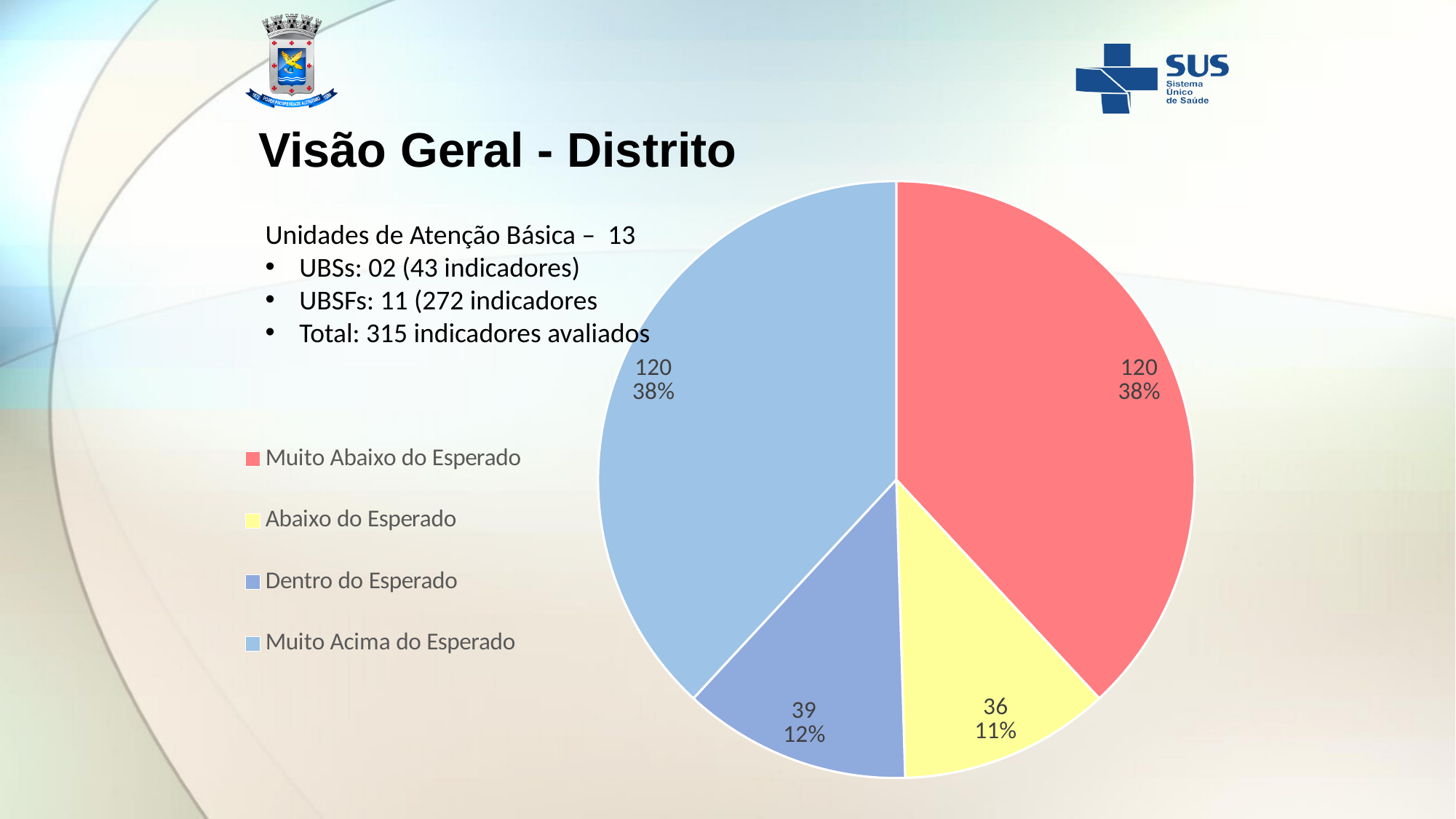
What is the value for Dentro do Esperado? 39 What share of the pie does Abaixo do Esperado represent? 11% Which is larger, Dentro do Esperado or Abaixo do Esperado? Dentro do Esperado How many slices does the pie chart have? 4 What is the difference between the values for Muito Abaixo do Esperado and Dentro do Esperado? 81 What is the value for Abaixo do Esperado? 36 What is the value for Muito Acima do Esperado? 120 What kind of chart is shown on the slide? pie chart What is the value for Muito Abaixo do Esperado? 120 Which colour represents Muito Acima do Esperado in the legend? light blue What share of the pie does Dentro do Esperado represent? 12% Which category has the lowest value? Abaixo do Esperado